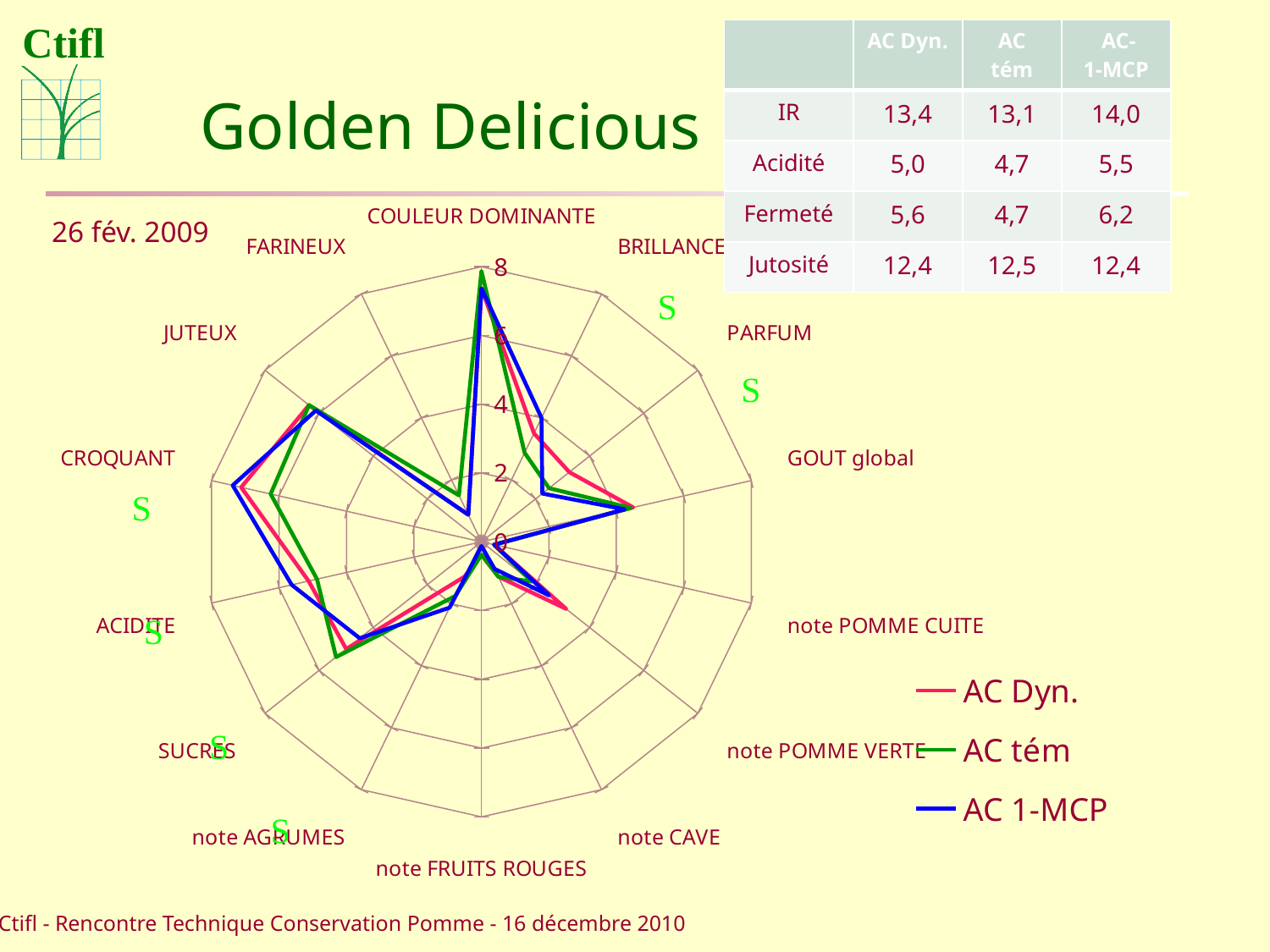
Which category has the highest value for the AC tém series? COULEUR DOMINANTE Which series is drawn in blue in the radar chart? AC 1-MCP How many categories (axes) does the radar chart have? 14 What date is shown next to the radar chart? 26 fév. 2009 Is the value for BRILLANCE for AC Dyn. greater or less than 6? less For the AC tém series, which is larger: COULEUR DOMINANTE or FARINEUX? COULEUR DOMINANTE Is the value for FARINEUX for AC tém greater or less than 4? less What kind of chart is shown on the slide? radar chart Is the value for COULEUR DOMINANTE for AC 1-MCP greater or less than 6? greater How many series does the chart legend list? 3